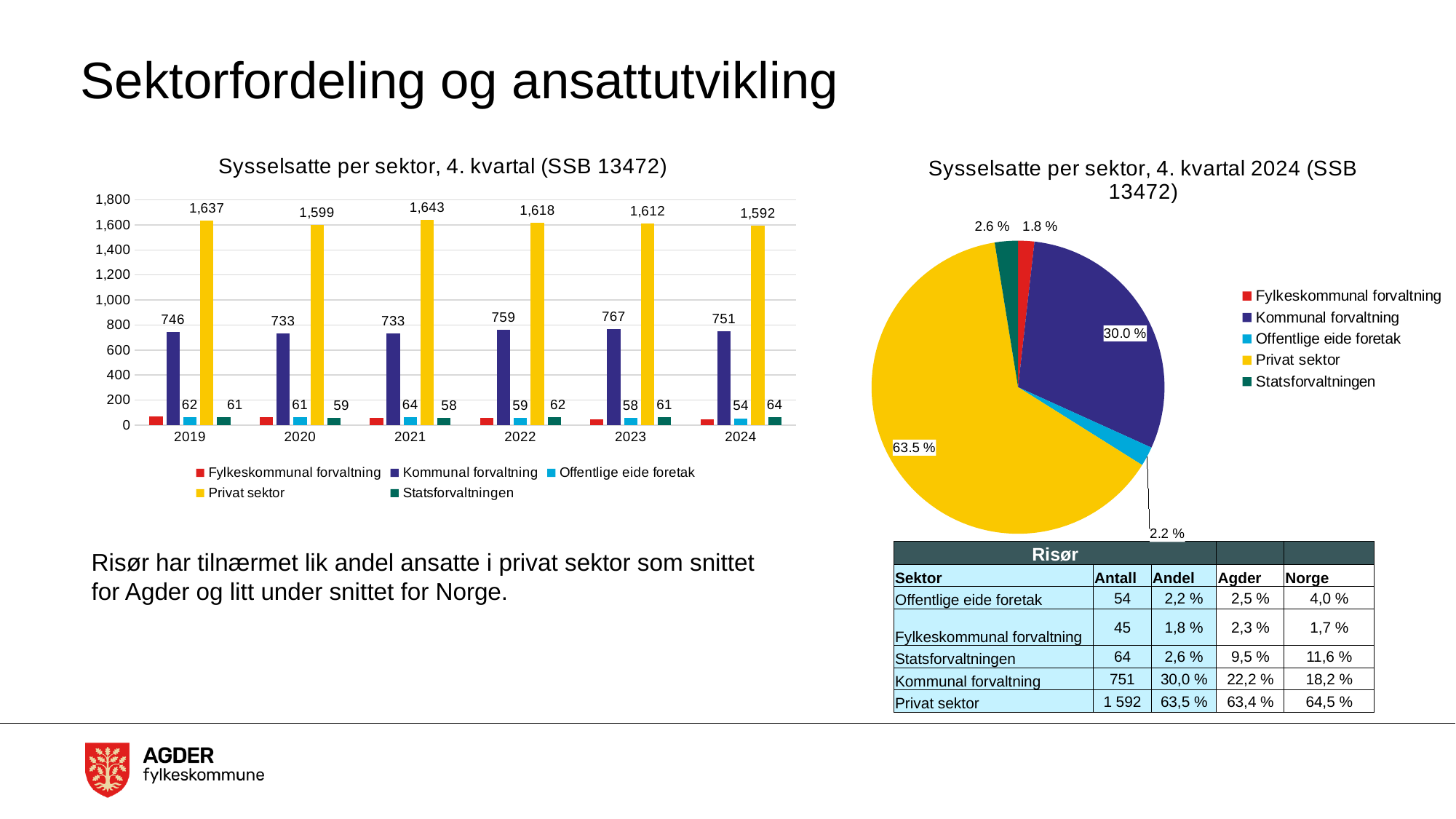
In the bar chart 'Sysselsatte per sektor, 4. kvartal (SSB 13472)', what is the value for Privat sektor in 2021? 1,643 In the bar chart 'Sysselsatte per sektor, 4. kvartal (SSB 13472)', what is the value for Kommunal forvaltning in 2023? 767 In the pie chart 'Sysselsatte per sektor, 4. kvartal 2024 (SSB 13472)', which sector has the smallest slice? Fylkeskommunal forvaltning How many series does the legend of the bar chart 'Sysselsatte per sektor, 4. kvartal (SSB 13472)' list? 5 In the bar chart 'Sysselsatte per sektor, 4. kvartal (SSB 13472)', what is the difference between the Privat sektor values for 2019 and 2024? 45 In the bar chart 'Sysselsatte per sektor, 4. kvartal (SSB 13472)', in which year is the Privat sektor value highest? 2021 In the bar chart 'Sysselsatte per sektor, 4. kvartal (SSB 13472)', which year has the larger Kommunal forvaltning value, 2020 or 2022? 2022 In the bar chart 'Sysselsatte per sektor, 4. kvartal (SSB 13472)', is the value for Fylkeskommunal forvaltning in 2019 greater or less than 200? less In the bar chart 'Sysselsatte per sektor, 4. kvartal (SSB 13472)', in which year is the Privat sektor value lowest? 2024 What kind of chart is 'Sysselsatte per sektor, 4. kvartal (SSB 13472)' on the left of the slide? bar chart In the pie chart 'Sysselsatte per sektor, 4. kvartal 2024 (SSB 13472)', what share does Kommunal forvaltning have? 30.0 % How many years are shown on the x axis of the bar chart 'Sysselsatte per sektor, 4. kvartal (SSB 13472)'? 6